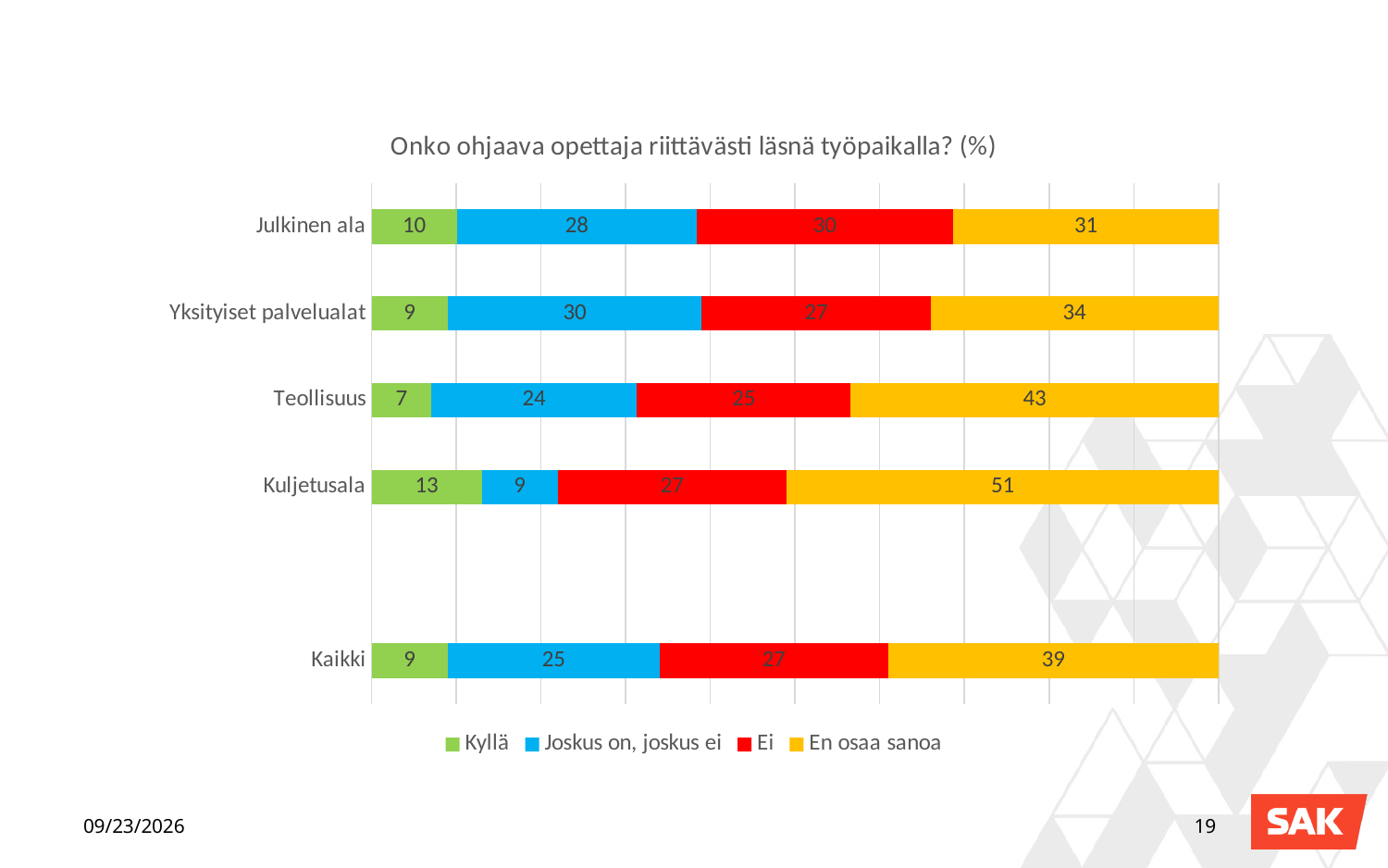
How many series does the legend list? 4 What is the difference between the "En osaa sanoa" values for Kuljetusala and Julkinen ala? 20 Which category has the lowest value for "Kyllä"? Teollisuus What is the value for "Joskus on, joskus ei" in the Teollisuus bar? 24 What is the title of the chart? Onko ohjaava opettaja riittävästi läsnä työpaikalla? (%) What is the value for "Kyllä" in the Julkinen ala bar? 10 What kind of chart is shown on the slide? Stacked bar chart Which category has the highest value for "En osaa sanoa"? Kuljetusala How many categories are shown on the y axis? 5 What is the value for "Ei" in the Kaikki bar? 27 Which is larger: the "Joskus on, joskus ei" value for Yksityiset palvelualat or for Kuljetusala? Yksityiset palvelualat What is the value for "En osaa sanoa" in the Kuljetusala bar? 51